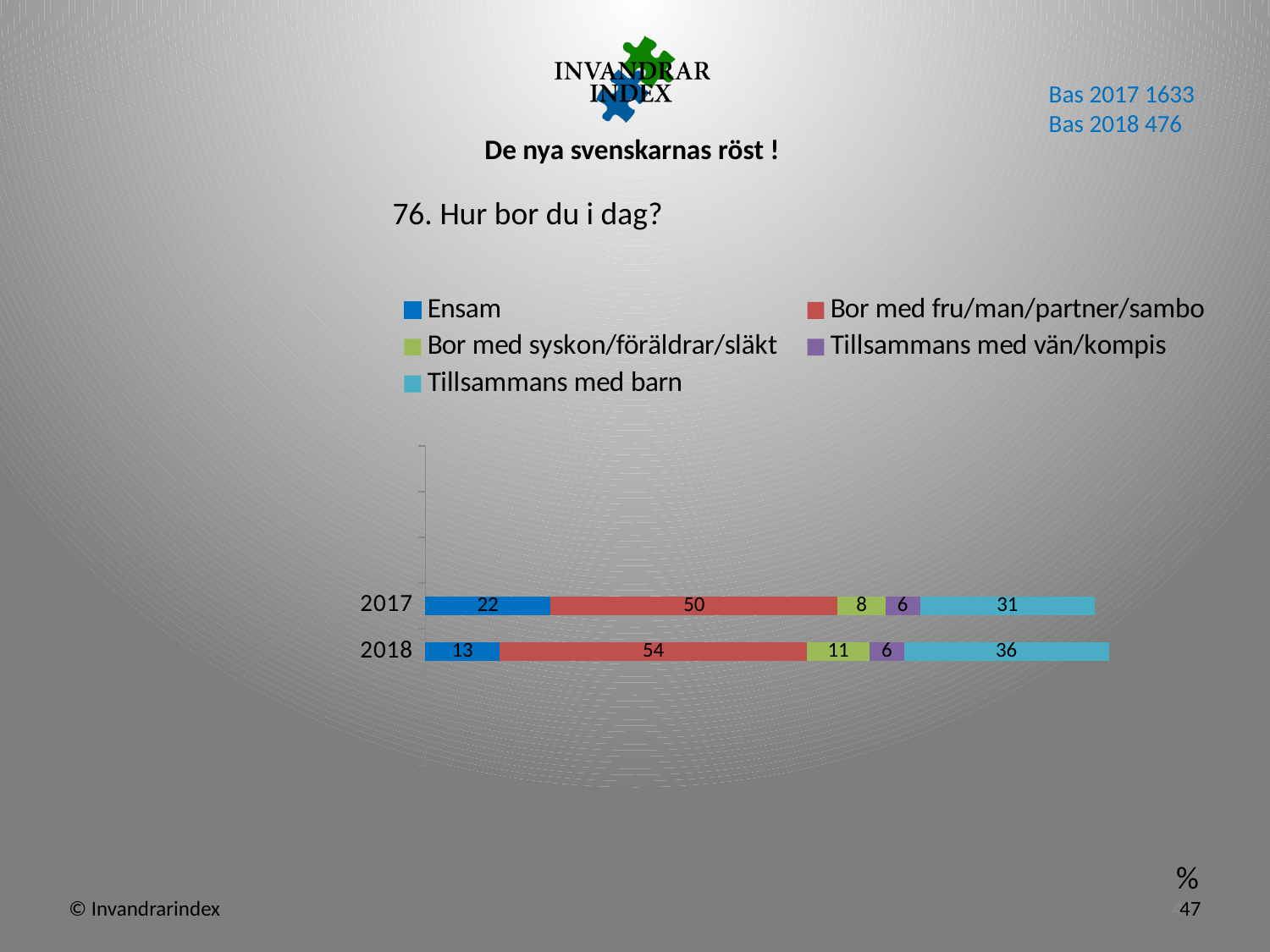
What is the value for Tillsammans med barn in 2017? 31 How many series does the legend list? 5 Which series has the highest value in the 2018 bar? Bor med fru/man/partner/sambo Which series has the lowest value in the 2017 bar? Tillsammans med vän/kompis Which year has the larger value for Tillsammans med barn, 2017 or 2018? 2018 What is the difference between the Ensam values for 2017 and 2018? 9 What is the value for Ensam in 2017? 22 What is the value for Bor med fru/man/partner/sambo in 2018? 54 How many years (categories) are shown in the chart? 2 What kind of chart is shown on the slide? Stacked bar chart What is the value for Bor med syskon/föräldrar/släkt in 2018? 11 What is the total of the stacked bar for 2018? 120